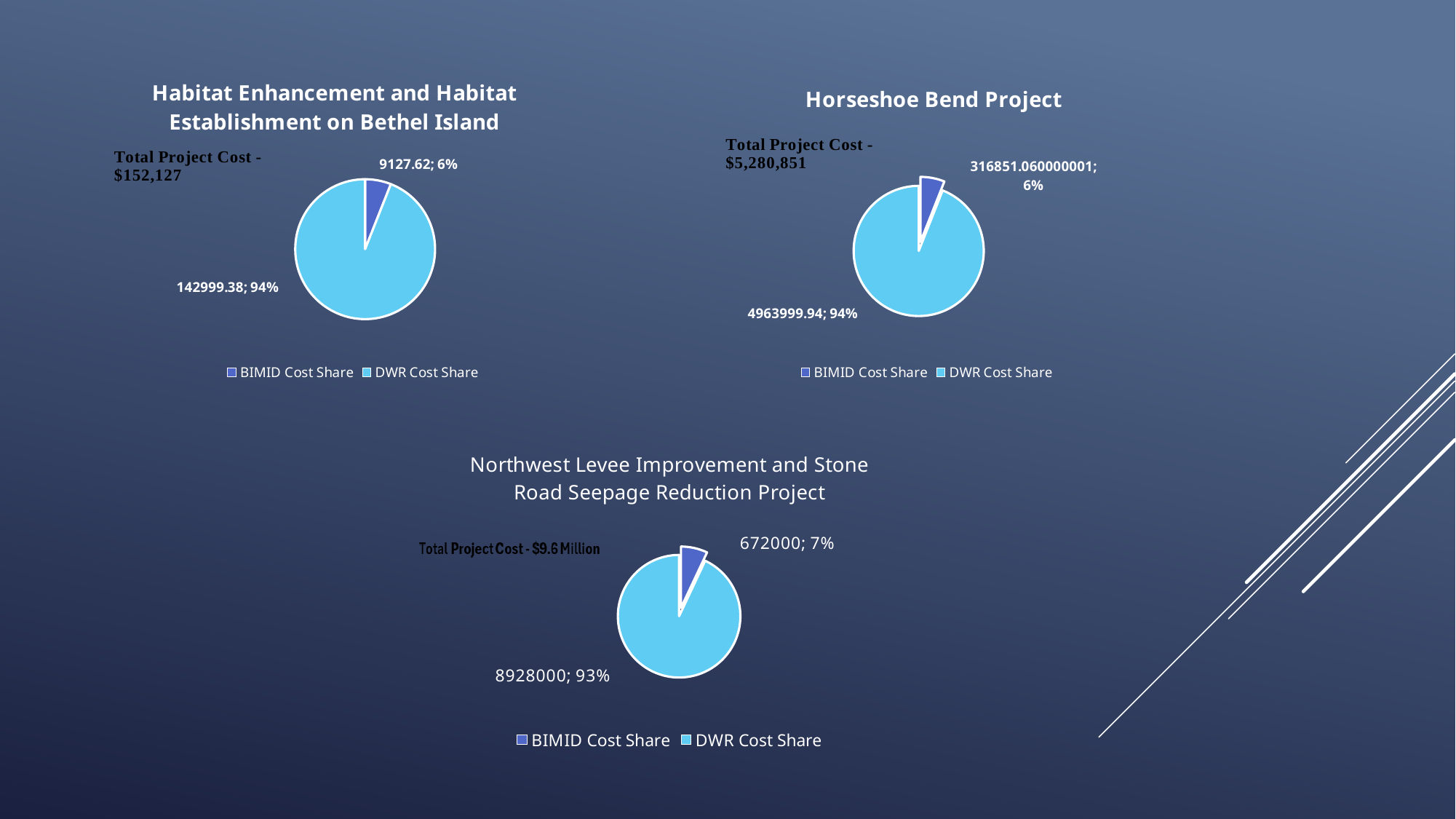
How many slices does the Northwest Levee Improvement and Stone Road Seepage Reduction Project pie chart have? 2 In the Northwest Levee Improvement and Stone Road Seepage Reduction Project chart, what is the value of the BIMID Cost Share slice? 672000 In the Northwest Levee Improvement and Stone Road Seepage Reduction Project chart, what is the difference between the DWR Cost Share and the BIMID Cost Share? 8256000 In the Horseshoe Bend Project chart, what share of the pie is the DWR Cost Share? 94% In the Habitat Enhancement and Habitat Establishment on Bethel Island chart, what share of the pie is the BIMID Cost Share? 6% In the Habitat Enhancement and Habitat Establishment on Bethel Island chart, what is the value of the DWR Cost Share slice? 142999.38 What kind of chart is the Horseshoe Bend Project chart? Pie chart In the Horseshoe Bend Project chart, which slice is the largest? DWR Cost Share In the Horseshoe Bend Project chart, what is the value of the DWR Cost Share slice? 4963999.94 In the Northwest Levee Improvement and Stone Road Seepage Reduction Project chart, what share of the pie is the BIMID Cost Share? 7% What total project cost is shown on the Horseshoe Bend Project chart? $5,280,851 In the Habitat Enhancement and Habitat Establishment on Bethel Island chart, which slice is the smallest? BIMID Cost Share